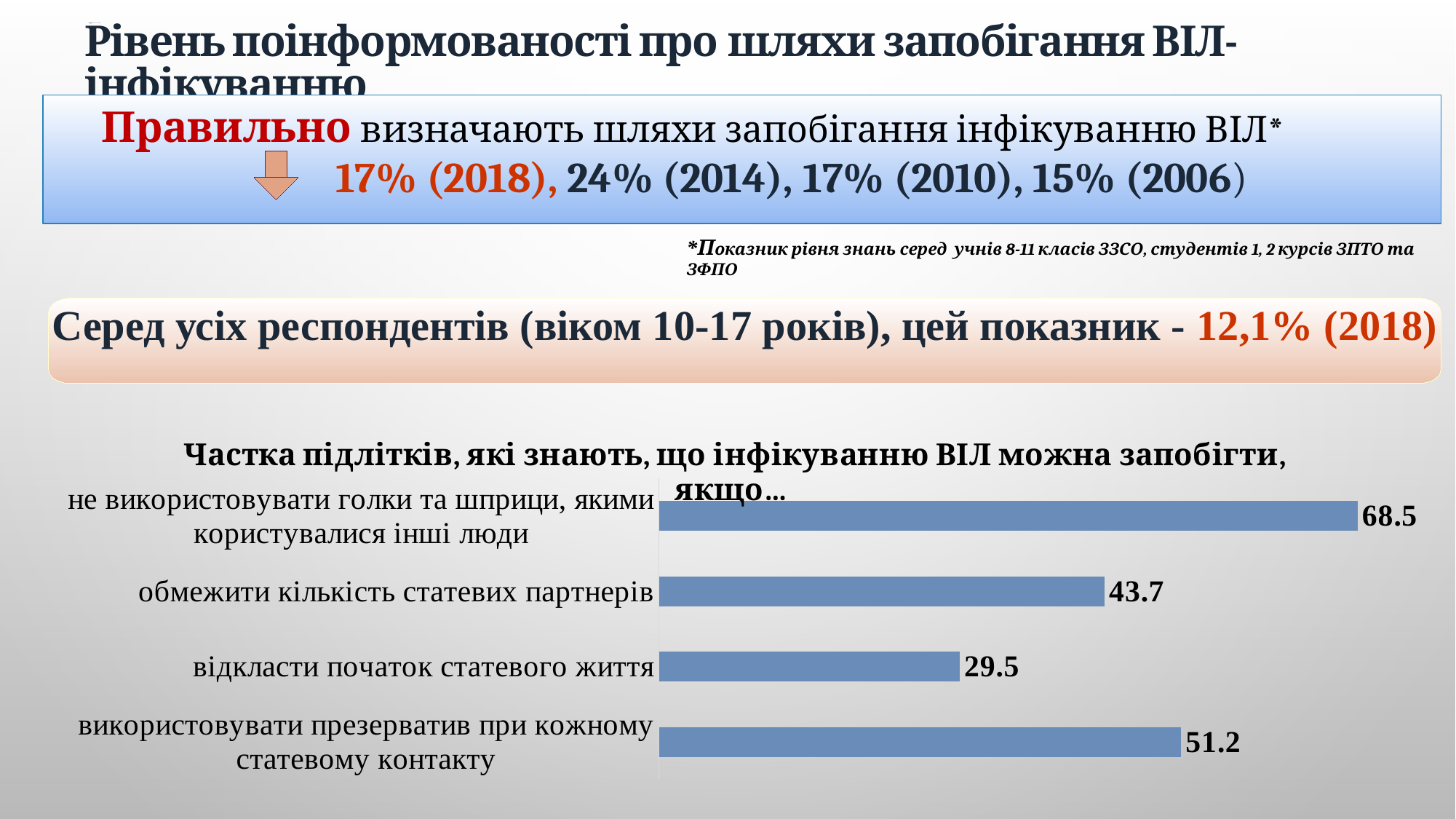
Which is larger: the value for "використовувати презерватив при кожному статевому контакту" or for "обмежити кількість статевих партнерів"? використовувати презерватив при кожному статевому контакту What is the difference between the values for "не використовувати голки та шприци, якими користувалися інші люди" and "відкласти початок статевого життя"? 39.0 Which category has the lowest value in the chart? відкласти початок статевого життя What value is shown for the category "не використовувати голки та шприци, якими користувалися інші люди"? 68.5 How many categories are shown in the chart? 4 What value is shown for "відкласти початок статевого життя"? 29.5 What is the title of the chart? Частка підлітків, які знають, що інфікуванню ВІЛ можна запобігти, якщо… What value is shown for "використовувати презерватив при кожному статевому контакту"? 51.2 What type of chart is shown on the slide? bar chart Which category has the highest value in the chart? не використовувати голки та шприци, якими користувалися інші люди What value is shown for "обмежити кількість статевих партнерів"? 43.7 What is the difference between the values for "використовувати презерватив при кожному статевому контакту" and "обмежити кількість статевих партнерів"? 7.5